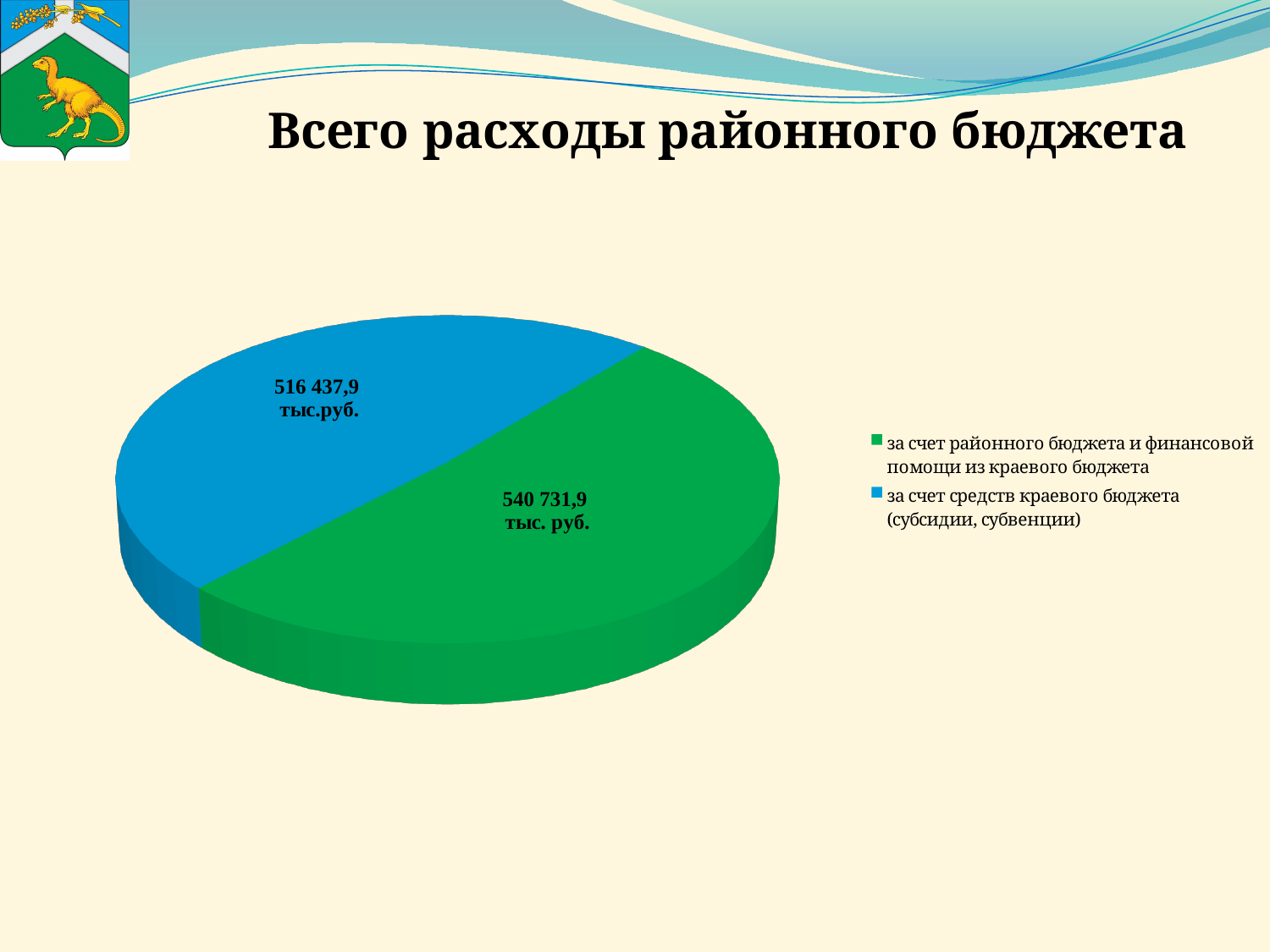
What is the total of the two slices in the pie chart? 1 057 169,8 тыс. руб. Which slice is the largest in the pie chart? за счет районного бюджета и финансовой помощи из краевого бюджета What colour is the slice for 'за счет средств краевого бюджета (субсидии, субвенции)'? Blue What is the difference between the two slices of the pie chart? 24 294,0 тыс. руб. What is the title of the chart on the slide? Всего расходы районного бюджета What kind of chart is shown on the slide? Pie chart How many slices does the pie chart have? 2 What is the value of the slice for 'за счет районного бюджета и финансовой помощи из краевого бюджета'? 540 731,9 тыс. руб. Which slice is the smallest in the pie chart? за счет средств краевого бюджета (субсидии, субвенции) How many entries does the legend list? 2 What is the value of the slice for 'за счет средств краевого бюджета (субсидии, субвенции)'? 516 437,9 тыс.руб. Which is larger: the slice for 'за счет районного бюджета и финансовой помощи из краевого бюджета' or the slice for 'за счет средств краевого бюджета (субсидии, субвенции)'? за счет районного бюджета и финансовой помощи из краевого бюджета